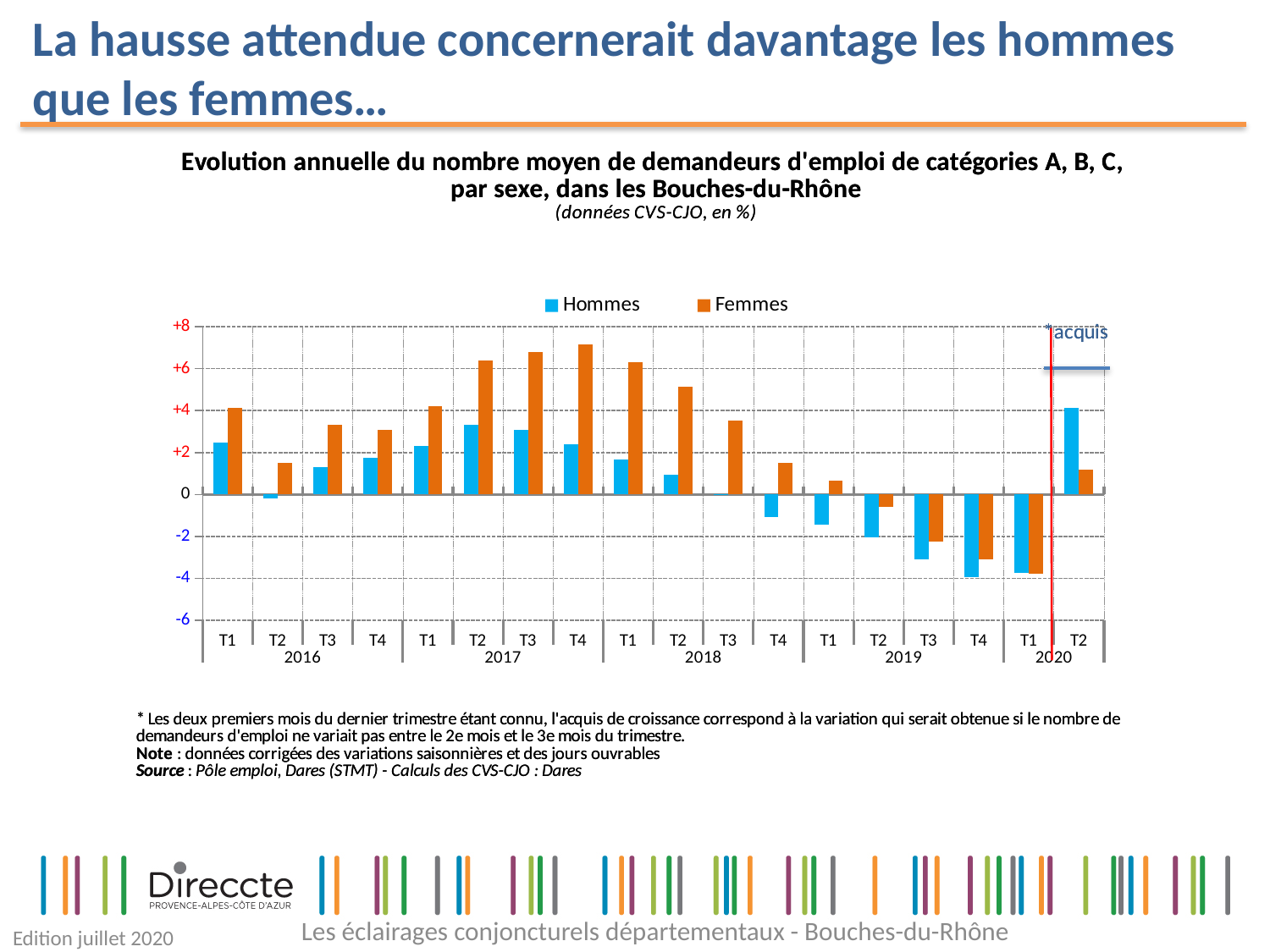
In T1 2016, which series has the higher value, Hommes or Femmes? Femmes Do the Femmes values rise or fall from T1 2019 to T4 2019? fall In T2 2020, which series has the higher value, Hommes or Femmes? Hommes In which quarter is the Hommes value highest? T2 2020 How many quarters are plotted along the x axis? 18 Is the Hommes value for T4 2019 greater or less than -2? less What kind of chart is shown on the slide? bar chart What are the two series named in the legend? Hommes and Femmes In which quarter is the Femmes value lowest? T1 2020 Is the Femmes value for T2 2018 greater or less than +4? greater Is the Femmes value for T4 2017 greater or less than +6? greater How many series does the legend list? 2